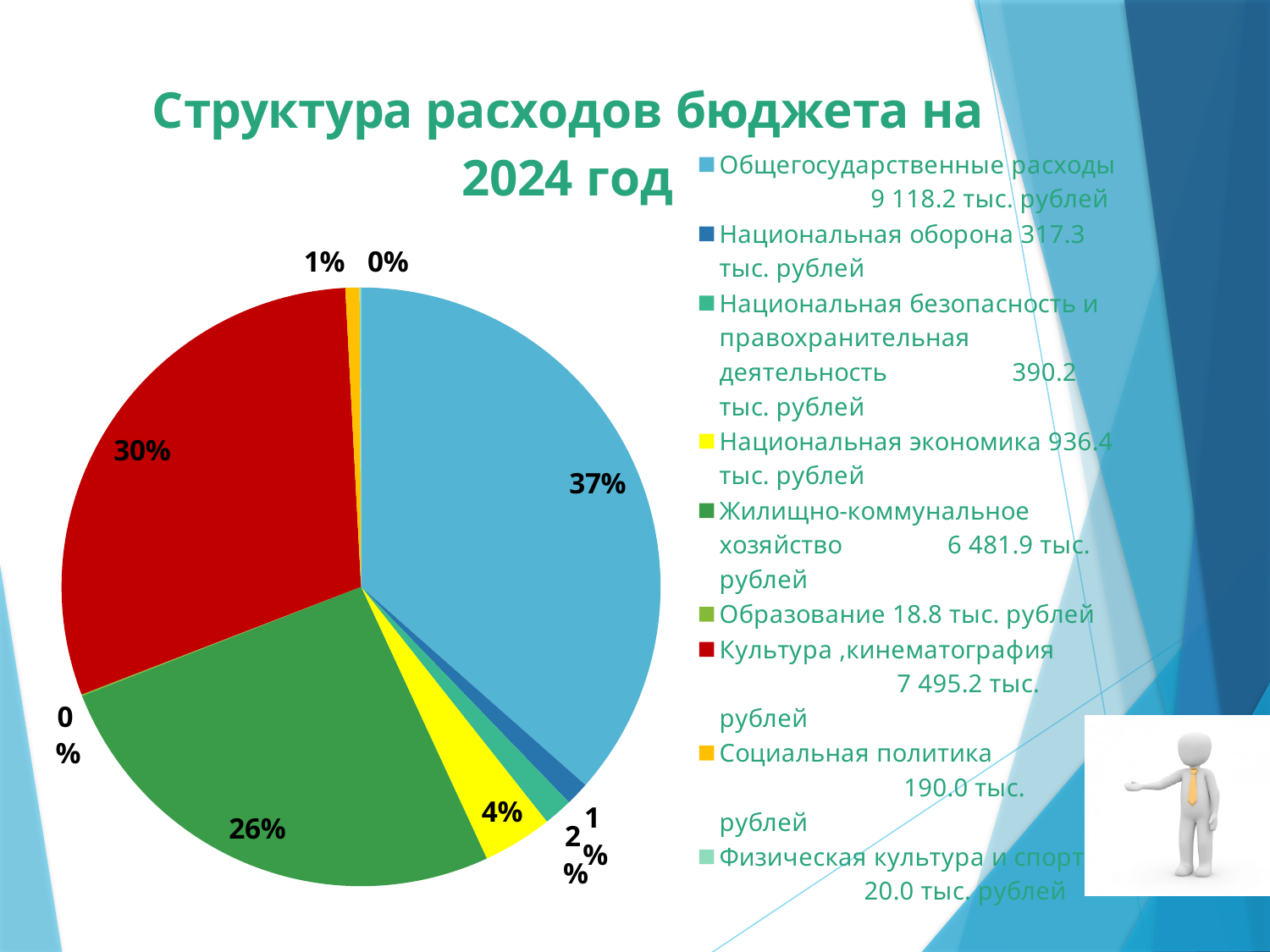
What share of the pie does Жилищно-коммунальное хозяйство take? 26% What type of chart is shown on the slide? pie chart What amount in thousand rubles does the legend give for Социальная политика? 190.0 тыс. рублей What is the title of the chart? Структура расходов бюджета на 2024 год What share of the pie does Национальная экономика take? 4% What amount in thousand rubles does the legend give for Жилищно-коммунальное хозяйство? 6 481.9 тыс. рублей What share of the pie does Культура, кинематография take? 30% What is the difference in percentage points between the Общегосударственные расходы slice and the Культура, кинематография slice? 7% Which category has the largest slice of the pie? Общегосударственные расходы How many categories does the legend of the pie chart list? 9 Which is larger: the slice for Культура, кинематография or the slice for Жилищно-коммунальное хозяйство? Культура, кинематография